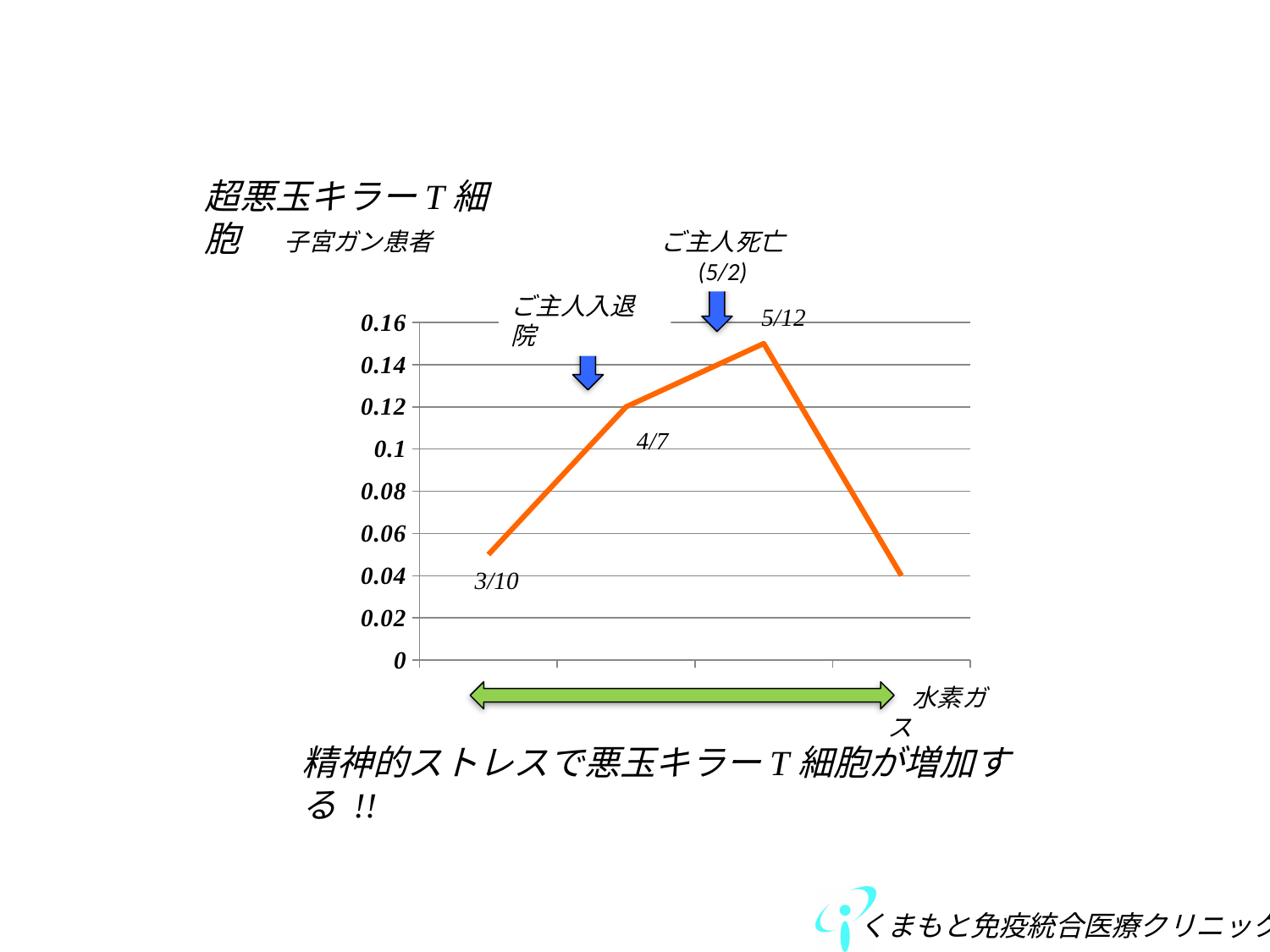
What date is given in parentheses under the annotation ご主人死亡? 5/2 What is the value at 4/7? 0.12 What is the highest value shown on the y axis? 0.16 How many data points are plotted on the line? 4 Is the value at 5/12 greater or less than 0.14? greater Does the line rise or fall from 3/10 to 5/12? rise Which is larger, the value at 3/10 or the value at 4/7? 4/7 Does the line rise or fall after 5/12? fall Is the value at 5/12 greater or less than 0.16? less Is the value at 3/10 greater or less than 0.06? less What kind of chart is shown on the slide? line chart Which labeled date has the highest value on the chart? 5/12